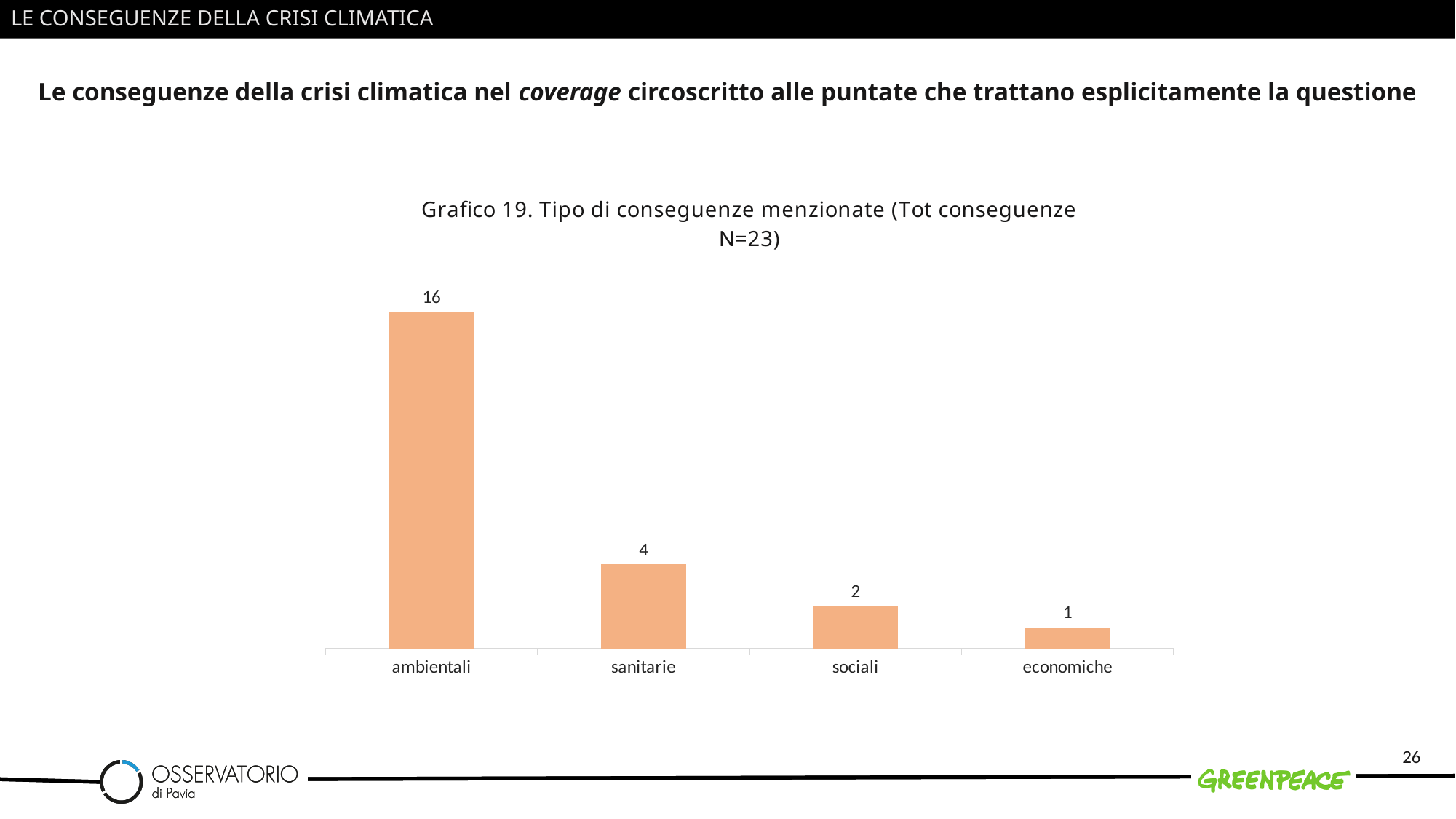
What is the value for sanitarie? 4 What is the difference between the values for ambientali and sanitarie? 12 What is the value for economiche? 1 What is the difference between the values for sociali and economiche? 1 What kind of chart is shown on the slide? bar chart What is the value for sociali? 2 What is the title of the chart? Grafico 19. Tipo di conseguenze menzionate (Tot conseguenze N=23) Which category has the lowest value? economiche Which is larger, the value for sanitarie or the value for sociali? sanitarie Which category has the highest value? ambientali How many categories are shown on the x axis? 4 What is the value for ambientali? 16